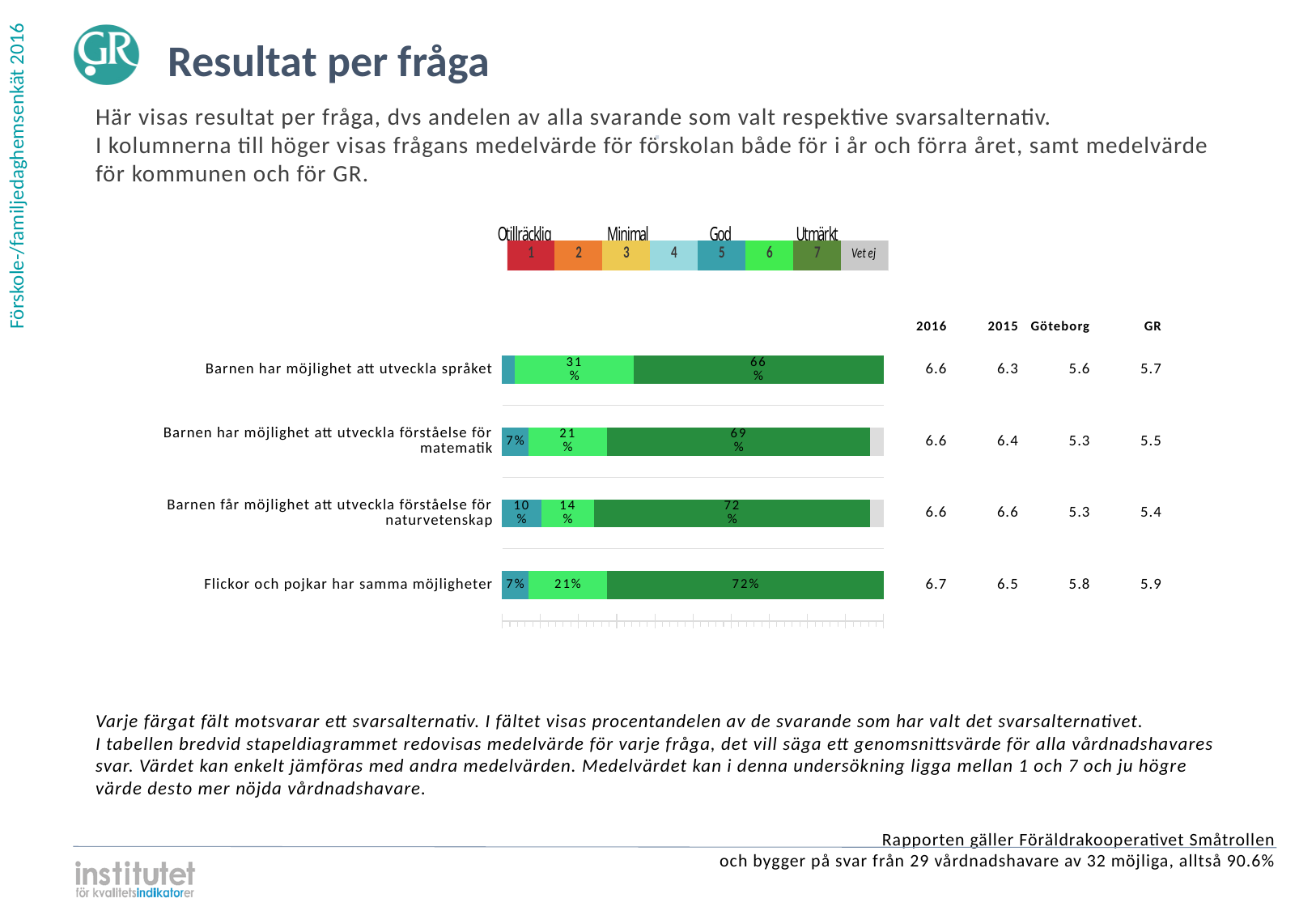
What percentage of respondents chose answer 6 for "Flickor och pojkar har samma möjligheter"? 21% How many answer alternatives does the legend above the chart list? 8 What is the 2016 mean value shown for "Flickor och pojkar har samma möjligheter"? 6.7 What is the difference between the answer-7 share for "Barnen får möjlighet att utveckla förståelse för naturvetenskap" and for "Barnen har möjlighet att utveckla språket"? 6 percentage points What percentage of respondents chose answer 7 (Utmärkt) for "Barnen har möjlighet att utveckla språket"? 66% What is the Göteborg mean value shown for "Barnen har möjlighet att utveckla förståelse för matematik"? 5.3 What percentage of respondents chose answer 5 for "Barnen får möjlighet att utveckla förståelse för naturvetenskap"? 10% Which is larger: the answer-6 share for "Barnen har möjlighet att utveckla språket" or for "Barnen har möjlighet att utveckla förståelse för matematik"? Barnen har möjlighet att utveckla språket How many questions (bars) are shown in the chart? 4 Which question has the lowest share of answer 6 (the light green segment)? Barnen får möjlighet att utveckla förståelse för naturvetenskap What type of chart is used to show the results per question? Stacked bar chart Which question has the highest 2016 mean value in the table? Flickor och pojkar har samma möjligheter